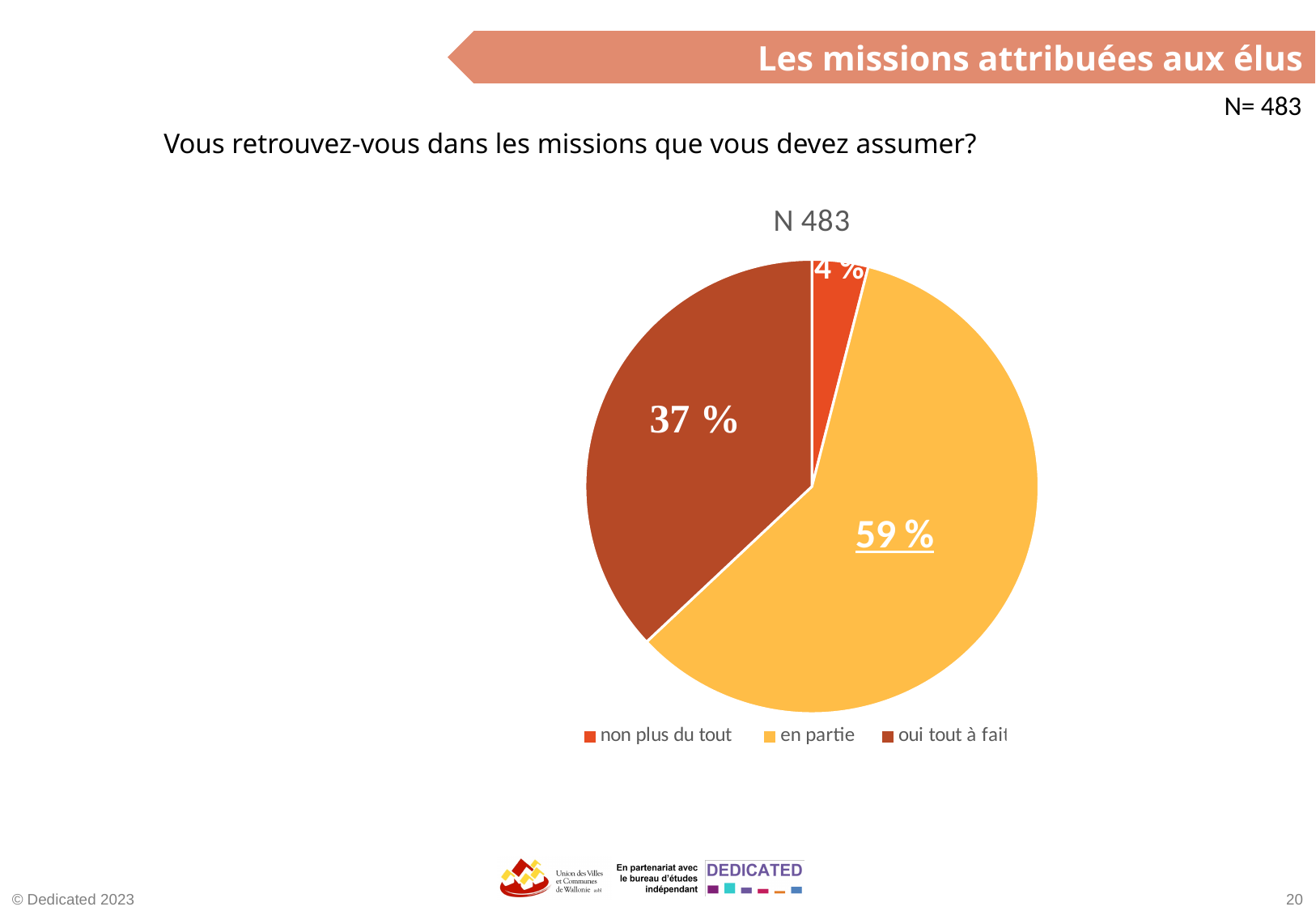
What is the chart's title? N 483 Which category has the largest slice of the pie? en partie Which category has the smallest slice of the pie? non plus du tout What share of the pie is 'non plus du tout'? 4 % What colour is the slice for 'en partie'? yellow How many slices does the pie chart have? 3 Which is larger, the slice for 'oui tout à fait' or the slice for 'non plus du tout'? oui tout à fait What share of the pie is 'oui tout à fait'? 37 % How many entries does the legend list? 3 What is the difference in percentage points between 'en partie' and 'oui tout à fait'? 22 What kind of chart is shown on the slide? pie chart What share of the pie is 'en partie'? 59 %